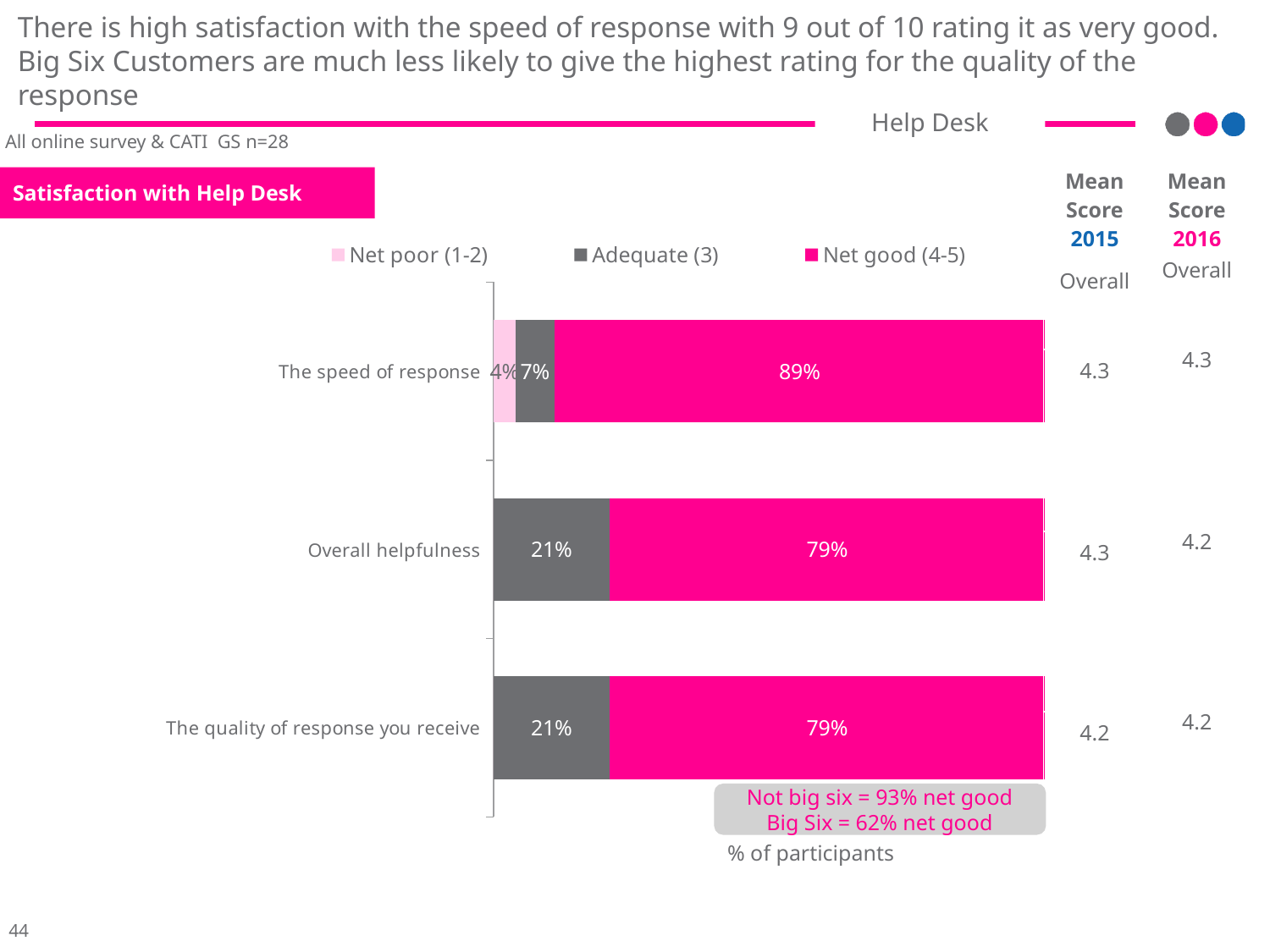
How many categories are shown in the chart? 3 What kind of chart is shown on the slide? Stacked bar chart Is the Net good (4-5) percentage larger for the speed of response or for the quality of response you receive? The speed of response Which category has the lowest Adequate (3) percentage? The speed of response What is the total of the stacked bar for the speed of response? 100% What percentage of participants rated the speed of response as Net good (4-5)? 89% What is the difference between the Net good (4-5) percentage for the speed of response and for Overall helpfulness? 10% Which category has the highest Net good (4-5) percentage? The speed of response What percentage of participants rated the quality of response you receive as Net good (4-5)? 79% What percentage of participants rated Overall helpfulness as Adequate (3)? 21% What percentage of participants rated the speed of response as Net poor (1-2)? 4% How many series does the legend list? 3